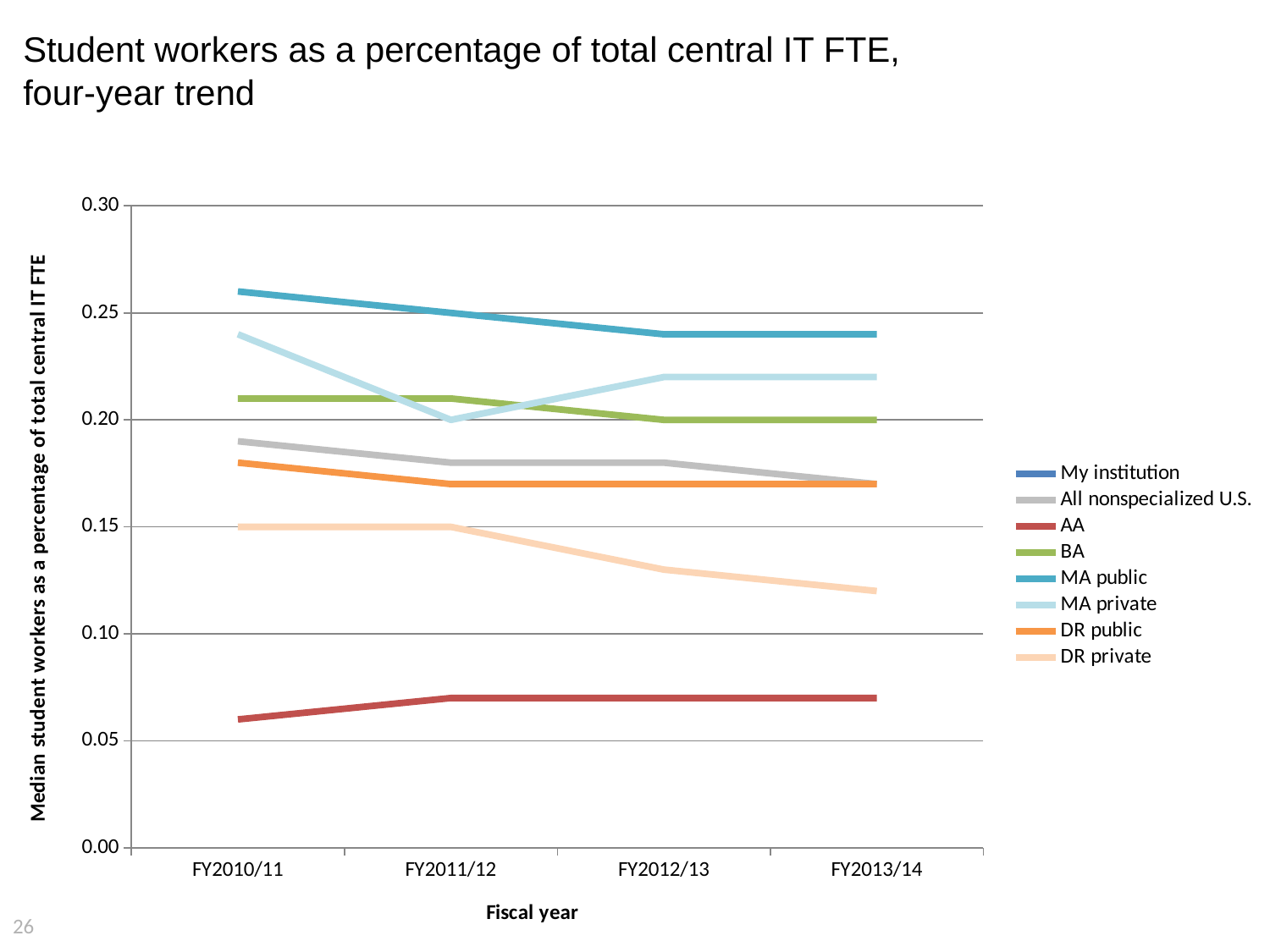
How many fiscal years are shown on the x axis? 4 Is the value for DR private in FY2013/14 greater or less than 0.10? greater Which series has the lowest value in FY2013/14? AA What kind of chart is shown on the slide? line chart Is the value for All nonspecialized U.S. in FY2010/11 greater or less than 0.20? less Is the value for AA in FY2010/11 greater or less than 0.10? less How many series does the legend list? 8 What is the label of the y axis? Median student workers as a percentage of total central IT FTE Which is larger in FY2013/14, MA public or BA? MA public Does the DR private line rise or fall from FY2011/12 to FY2013/14? fall Which series has the highest value in FY2010/11? MA public